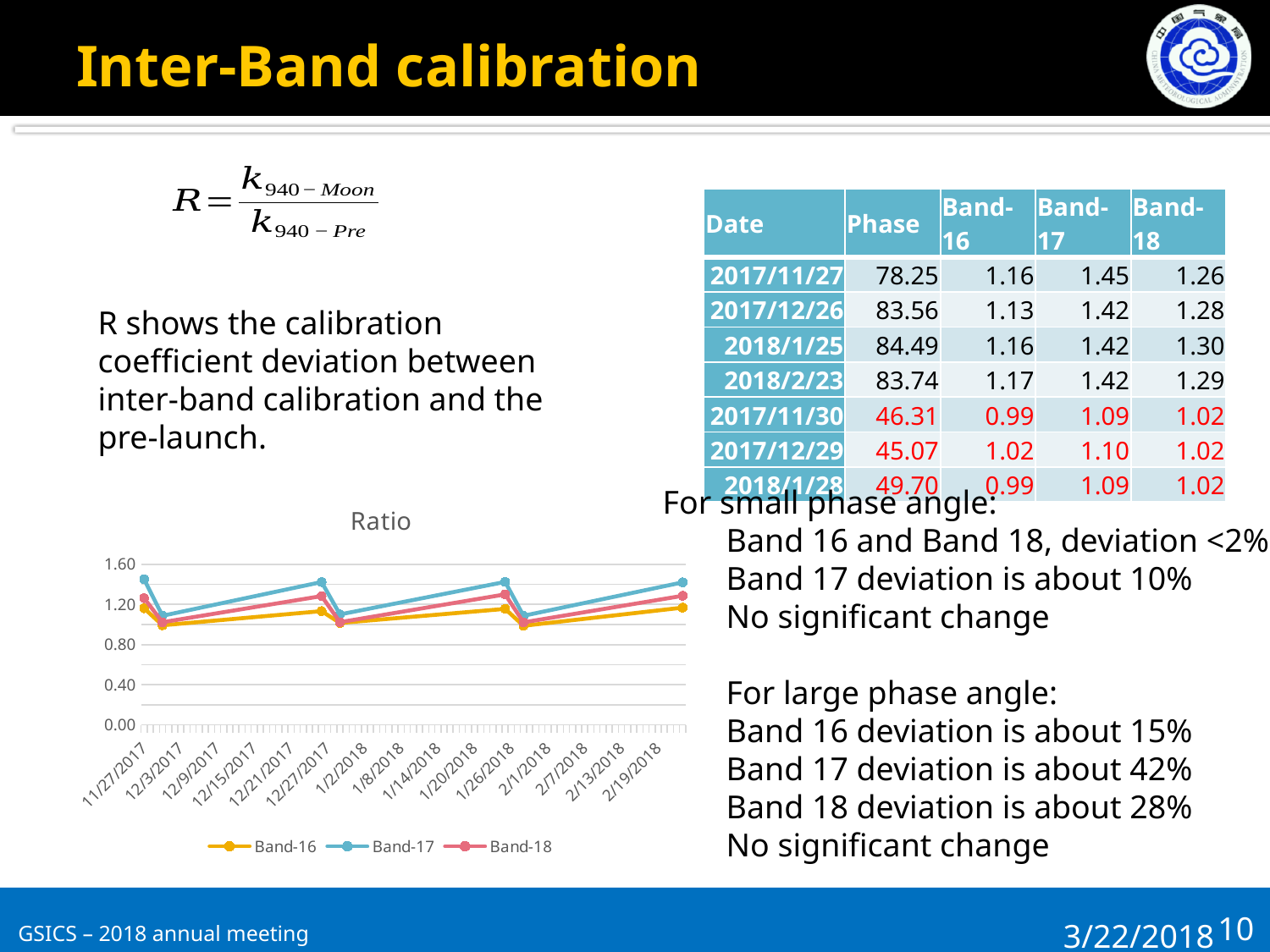
In the Ratio chart, is the lowest value for Band-18 greater or less than 0.80? greater How many series does the legend of the Ratio chart list? 3 What is the title of the chart on the slide? Ratio What type of chart is shown on the slide? line chart Which series in the Ratio chart has the highest values? Band-17 How many data points does each series in the Ratio chart have? 7 In the Ratio chart, is the highest value for Band-17 greater or less than 1.20? greater In the Ratio chart, is the lowest value for Band-16 greater or less than 1.20? less What is the first date label on the x axis of the Ratio chart? 11/27/2017 In the Ratio chart, which series has the larger value at the first date, Band-17 or Band-16? Band-17 Does Band-17 in the Ratio chart show a steady rise across the x axis, or does it repeatedly rise and fall? repeatedly rise and fall What is the highest tick value shown on the y axis of the Ratio chart? 1.60